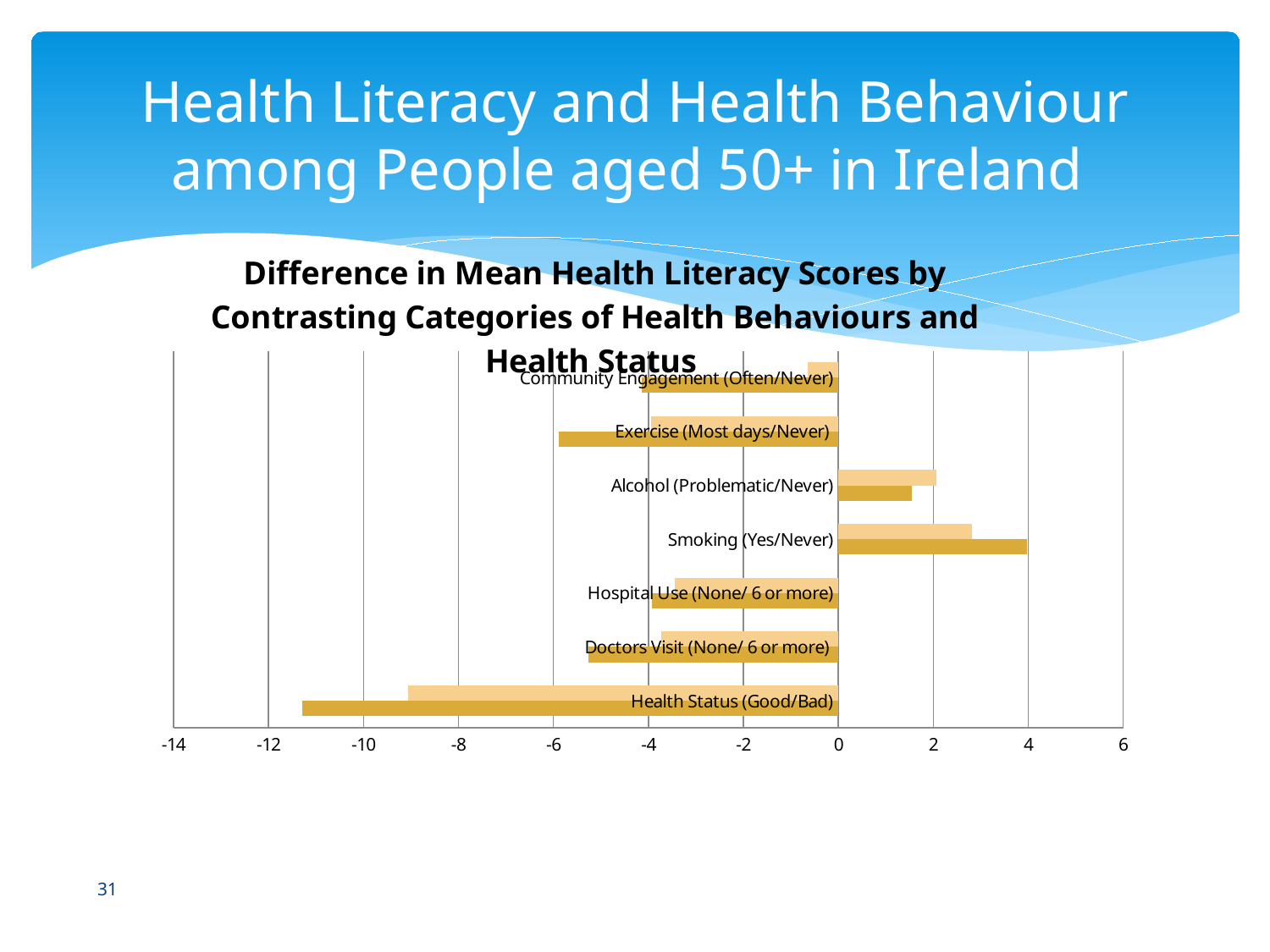
How many categories on the chart have positive values? 2 What is the title of the chart? Difference in Mean Health Literacy Scores by Contrasting Categories of Health Behaviours and Health Status What kind of chart is shown on the slide? bar chart Which is larger, the darker bar for Smoking (Yes/Never) or the darker bar for Alcohol (Problematic/Never)? Smoking (Yes/Never) Which category has the most negative (lowest) values on the chart? Health Status (Good/Bad) Which category has the largest positive value on the chart? Smoking (Yes/Never) Is the lighter bar for Health Status (Good/Bad) greater or less than -8? less How many categories are plotted on the chart? 7 Is the lighter bar for Community Engagement (Often/Never) greater or less than -2? greater Is the darker bar for Exercise (Most days/Never) greater or less than -4? less